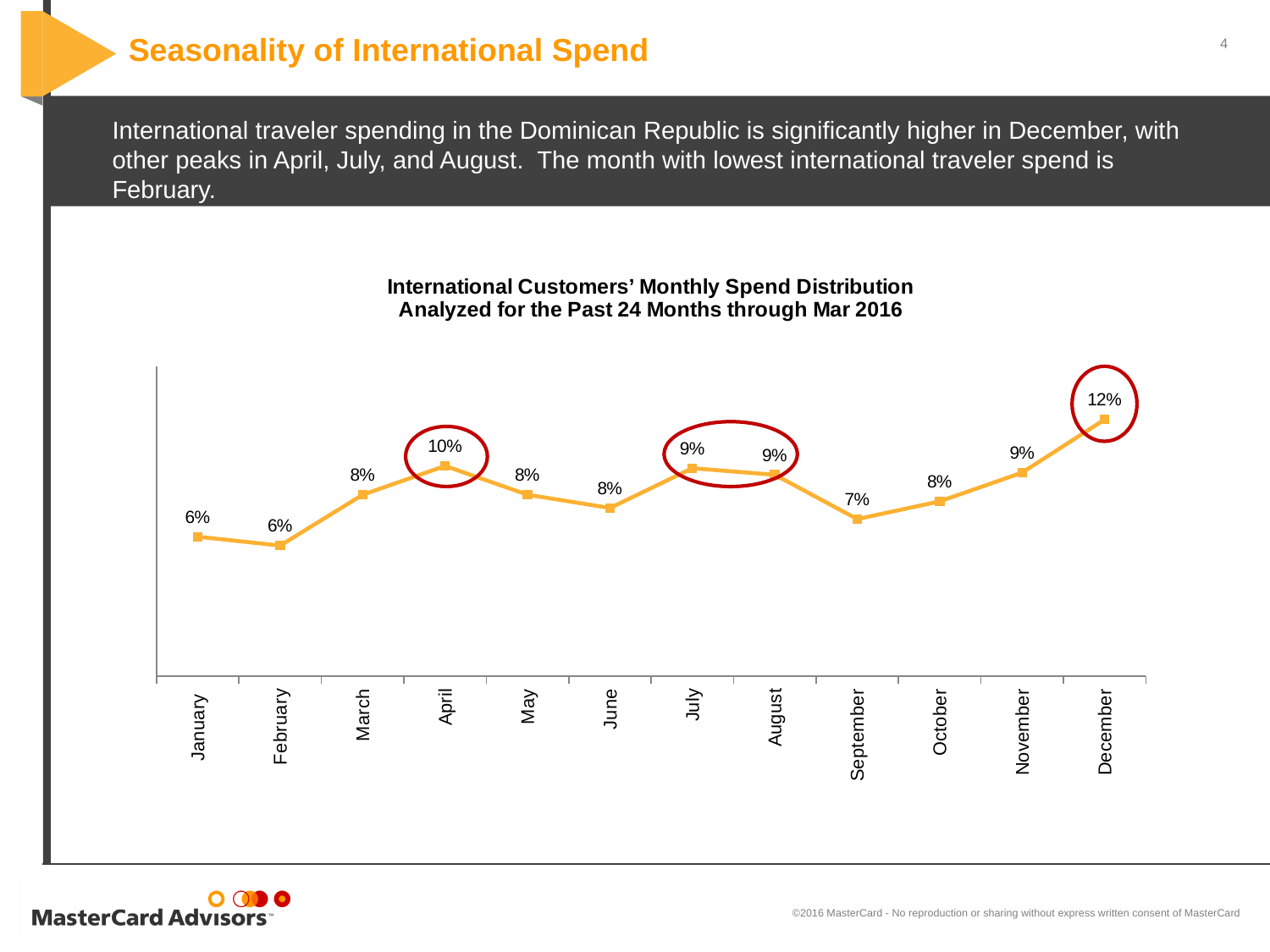
What is the title of the chart? International Customers' Monthly Spend Distribution Analyzed for the Past 24 Months through Mar 2016 What is the value for April? 10% Which month has the highest value? December What is the difference between the values for December and April? 2% Do the values rise or fall from September to December? Rise What type of chart is shown on the slide? Line chart How many months are plotted on the chart? 12 Which month has the lowest value? February Which is larger, the value for April or the value for July? April What is the value for September? 7% What is the value for December? 12% What is the value for January? 6%